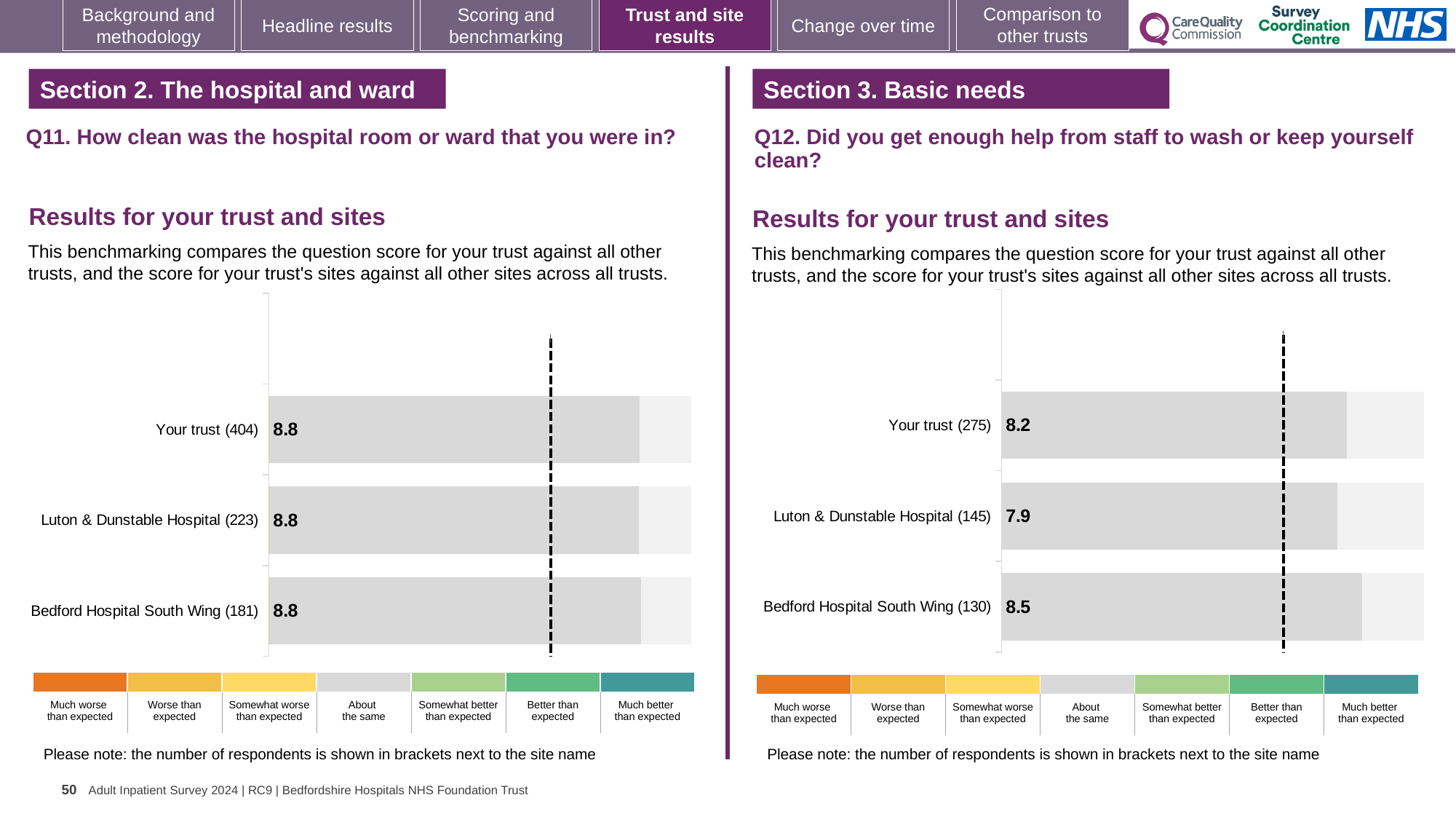
In the Q12 chart on the right, what is the score for Luton & Dunstable Hospital (145)? 7.9 In the Q12 chart on the right, what is the score for Bedford Hospital South Wing (130)? 8.5 How many bars are plotted in the Q11 chart on the left? 3 In the Q11 chart on the left, what is the score for Bedford Hospital South Wing (181)? 8.8 In the Q11 chart on the left, what is the score for Your trust (404)? 8.8 How many benchmark categories are shown in the colour key below the Q11 chart on the left? 7 In the Q12 chart on the right, what is the score for Your trust (275)? 8.2 In the Q12 chart on the right, what is the difference between the scores for Bedford Hospital South Wing (130) and Luton & Dunstable Hospital (145)? 0.6 In the Q12 chart on the right, which site or trust has the highest score? Bedford Hospital South Wing (130) What type of chart is used for the Q12 results on the right? Bar chart In the Q12 chart on the right, which site or trust has the lowest score? Luton & Dunstable Hospital (145) In the Q12 chart on the right, which has the larger score: Your trust (275) or Bedford Hospital South Wing (130)? Bedford Hospital South Wing (130)